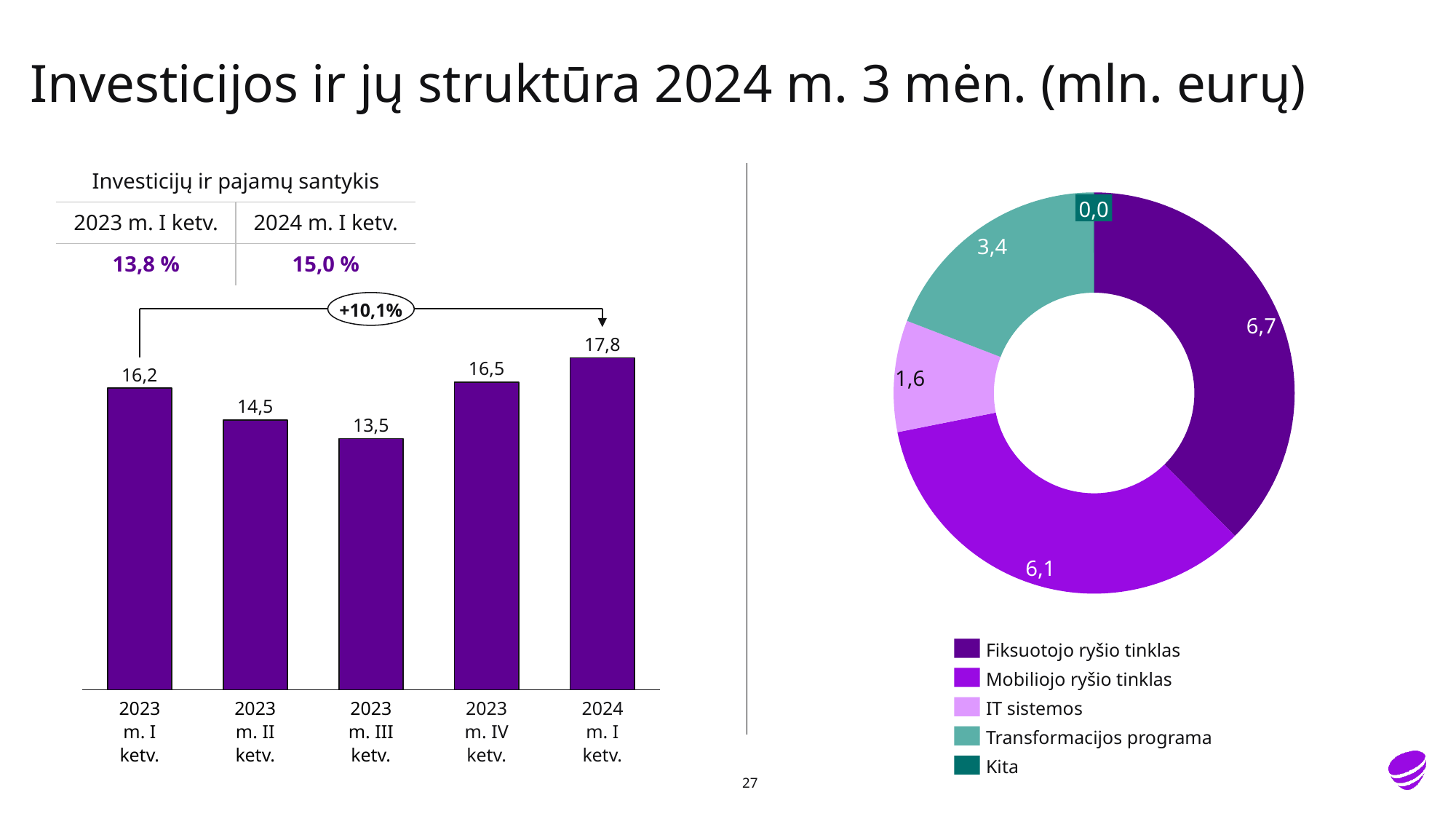
On the bar chart on the left, which is larger: the value for 2023 m. II ketv. or 2023 m. IV ketv.? 2023 m. IV ketv. On the bar chart on the left, what is the value for 2024 m. I ketv.? 17,8 How many categories does the legend of the donut chart on the right list? 5 On the donut chart on the right, what is the difference between Fiksuotojo ryšio tinklas and Mobiliojo ryšio tinklas? 0,6 On the bar chart on the left, which quarter has the lowest value? 2023 m. III ketv. On the donut chart on the right, what is the value for Mobiliojo ryšio tinklas? 6,1 On the bar chart on the left, what is the difference between the values for 2024 m. I ketv. and 2023 m. I ketv.? 1,6 On the bar chart on the left, what is the value for 2023 m. I ketv.? 16,2 How many bars are shown on the bar chart on the left? 5 On the donut chart on the right, which category has the largest value? Fiksuotojo ryšio tinklas On the bar chart on the left, which quarter has the highest value? 2024 m. I ketv. What type of chart is shown on the right side of the slide? Donut (pie) chart